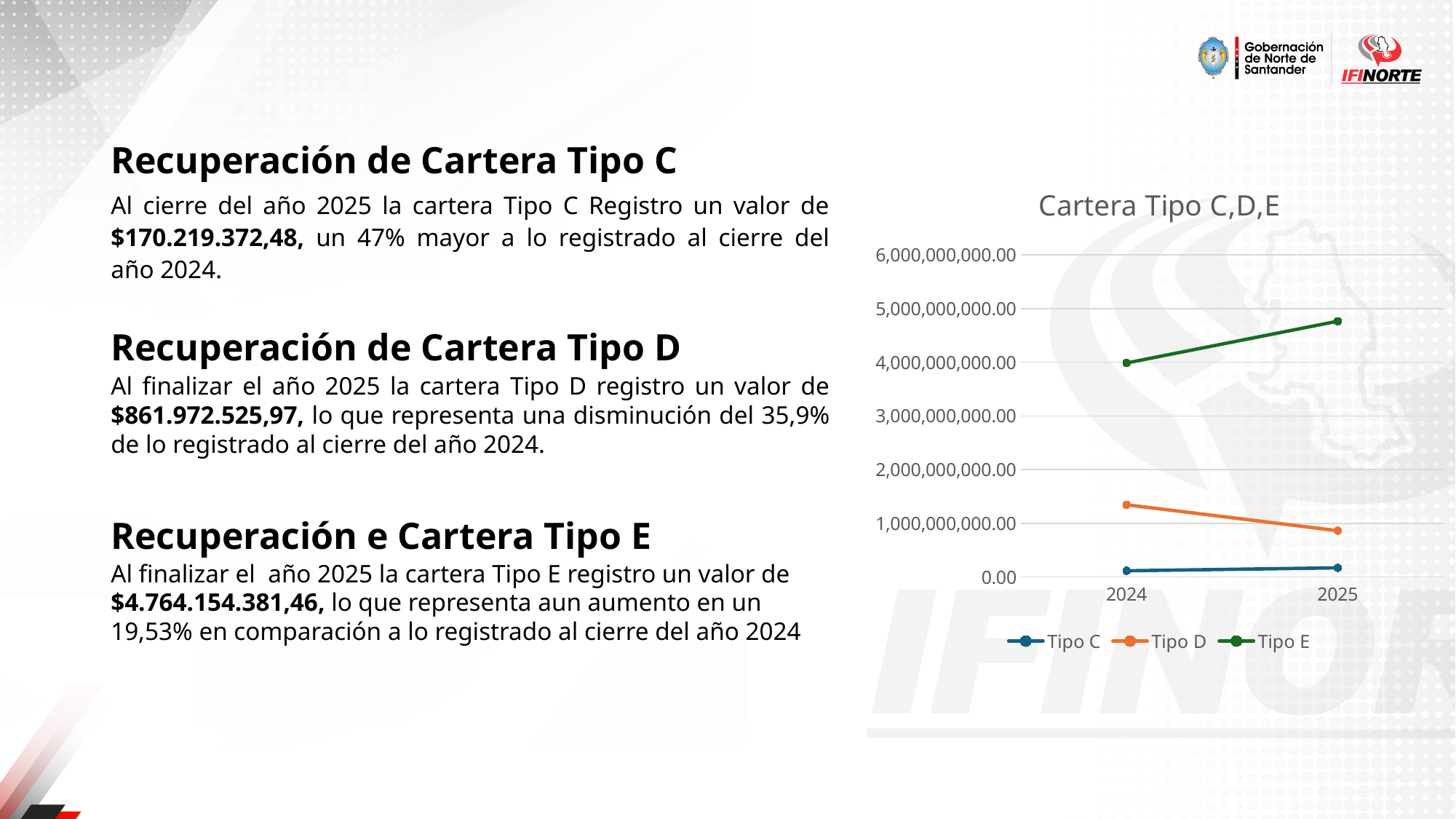
How many series does the chart legend list? 3 What kind of chart is shown on the slide? line chart Is the value for Tipo E in 2025 greater or less than 5,000,000,000.00? less Which series has the lowest value in 2024? Tipo C Is the value for Tipo D in 2024 greater or less than 1,000,000,000.00? greater What is the title of the chart? Cartera Tipo C,D,E Is the value for Tipo D in 2025 greater or less than 1,000,000,000.00? less Which series has the highest value in 2025? Tipo E Which is larger in 2024, the value for Tipo D or the value for Tipo C? Tipo D Does the value for Tipo E rise or fall from 2024 to 2025? rise How many years are shown on the x axis of the chart? 2 Does the value for Tipo D rise or fall from 2024 to 2025? fall